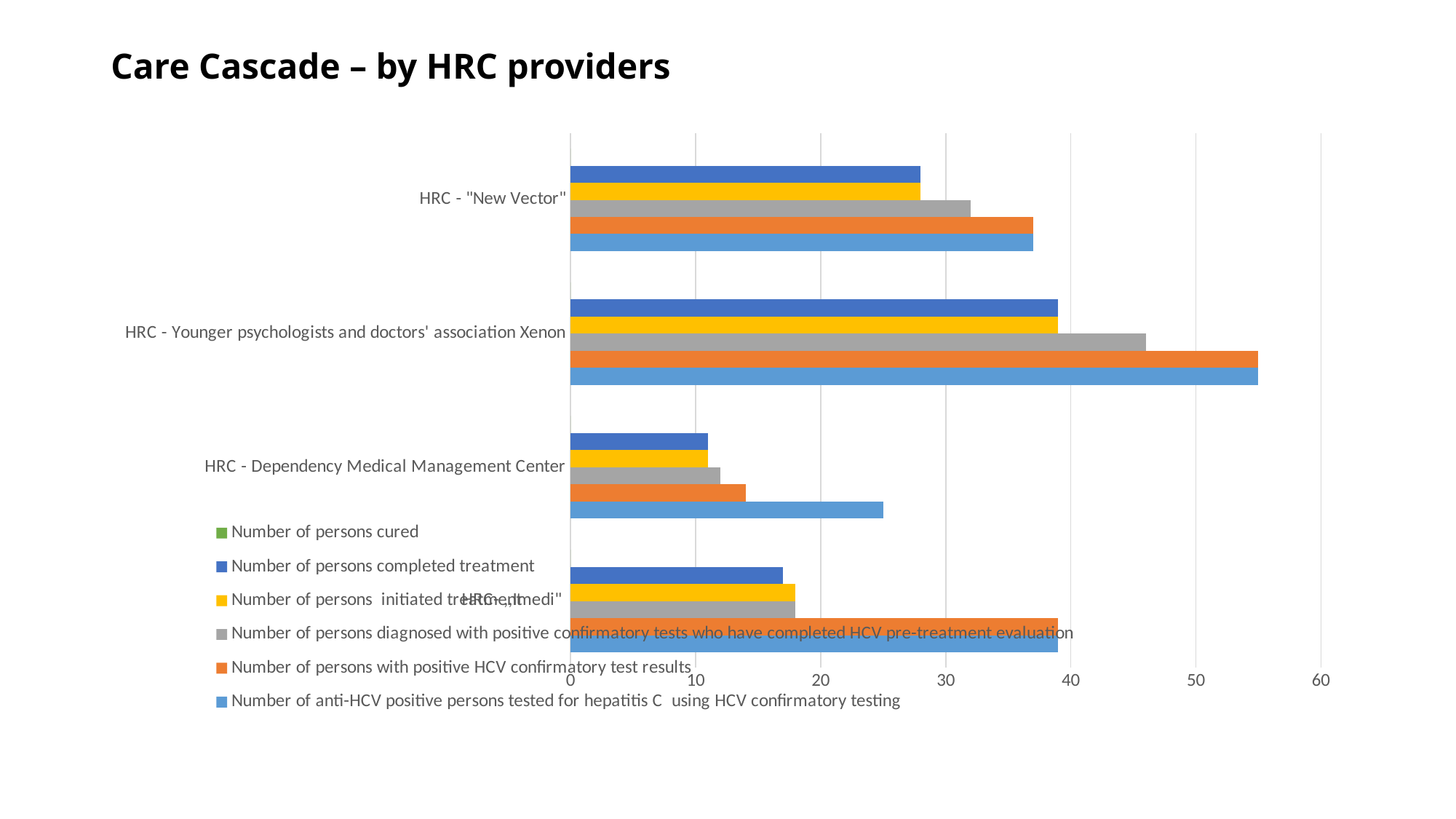
How many HRC provider categories are plotted on the chart? 4 What is the title of the chart? Care Cascade – by HRC providers Which has more persons with positive HCV confirmatory test results: HRC - "New Vector" or HRC - Younger psychologists and doctors' association Xenon? HRC - Younger psychologists and doctors' association Xenon Is the number of persons completed treatment for HRC - "New Vector" greater or less than 30? less Is the number of anti-HCV positive persons tested using HCV confirmatory testing for HRC - Younger psychologists and doctors' association Xenon greater or less than 50? greater Is the number of persons diagnosed with positive confirmatory tests who have completed HCV pre-treatment evaluation for HRC - Younger psychologists and doctors' association Xenon greater or less than 40? greater What colour does the legend use for "Number of persons cured"? green How many series does the legend list? 6 Which HRC provider has the highest number of anti-HCV positive persons tested for hepatitis C using HCV confirmatory testing? HRC - Younger psychologists and doctors' association Xenon Which HRC provider has the lowest number of anti-HCV positive persons tested for hepatitis C using HCV confirmatory testing? HRC - Dependency Medical Management Center What kind of chart is shown on the slide? bar chart